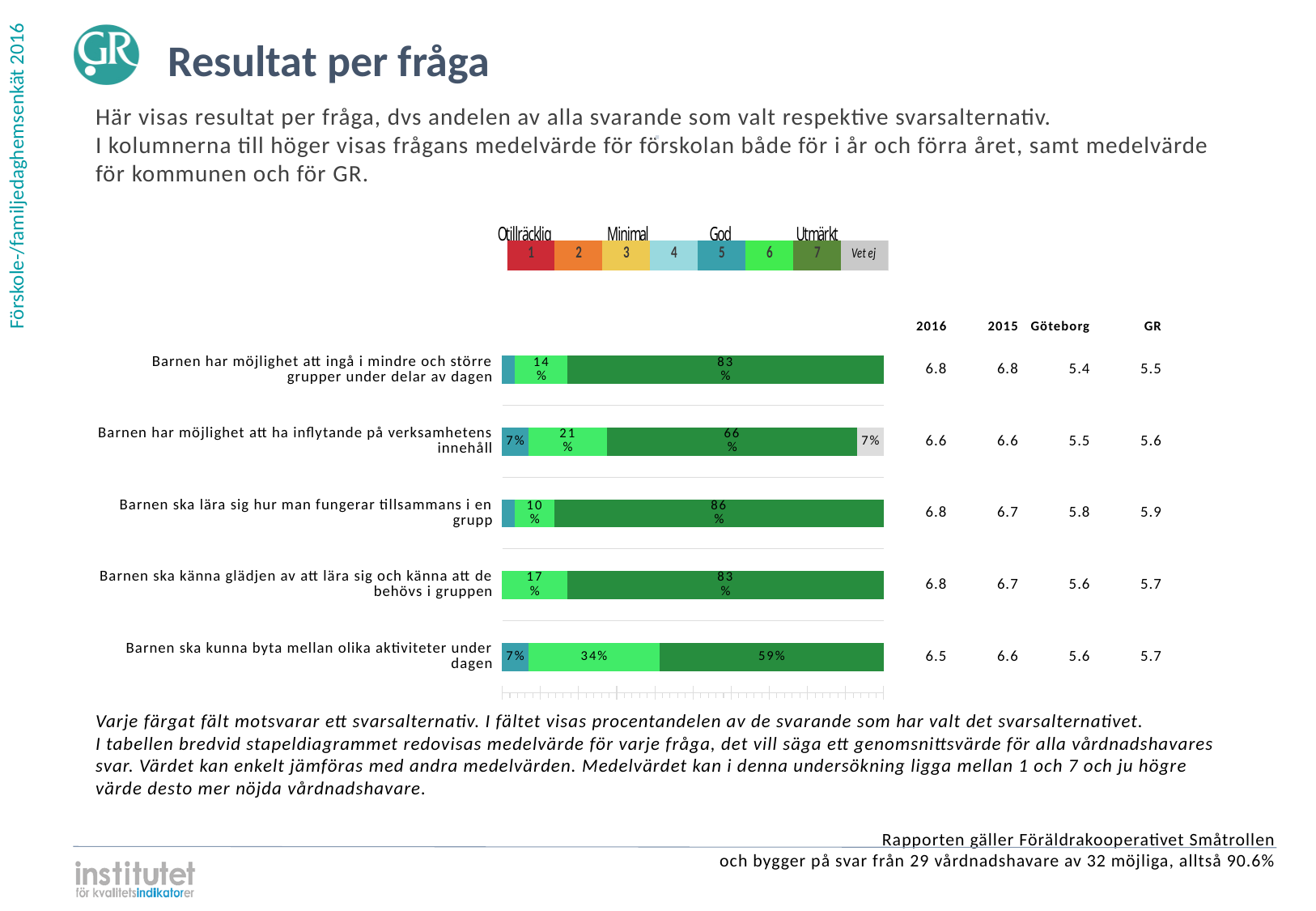
What kind of chart is shown on the slide? Stacked bar chart Which question has the highest share of respondents choosing answer 7? Barnen ska lära sig hur man fungerar tillsammans i en grupp What is the total of the labelled segments (7%, 34%, 59%) for "Barnen ska kunna byta mellan olika aktiviteter under dagen"? 100% How many questions (bars) are shown in the chart? 5 What are the four rating labels shown above the legend scale? Otillräcklig, Minimal, God, Utmärkt What percentage chose answer 5 for "Barnen ska kunna byta mellan olika aktiviteter under dagen"? 7% What percentage chose "Vet ej" for "Barnen har möjlighet att ha inflytande på verksamhetens innehåll"? 7% What percentage of respondents chose answer 7 for "Barnen ska lära sig hur man fungerar tillsammans i en grupp"? 86% Which question has the lowest share of respondents choosing answer 7? Barnen ska kunna byta mellan olika aktiviteter under dagen What percentage chose answer 6 for "Barnen ska kunna byta mellan olika aktiviteter under dagen"? 34% What is the difference in the share choosing answer 7 between "Barnen ska lära sig hur man fungerar tillsammans i en grupp" and "Barnen ska kunna byta mellan olika aktiviteter under dagen"? 27 percentage points Which question has a larger share choosing answer 6: "Barnen ska kunna byta mellan olika aktiviteter under dagen" or "Barnen har möjlighet att ha inflytande på verksamhetens innehåll"? Barnen ska kunna byta mellan olika aktiviteter under dagen